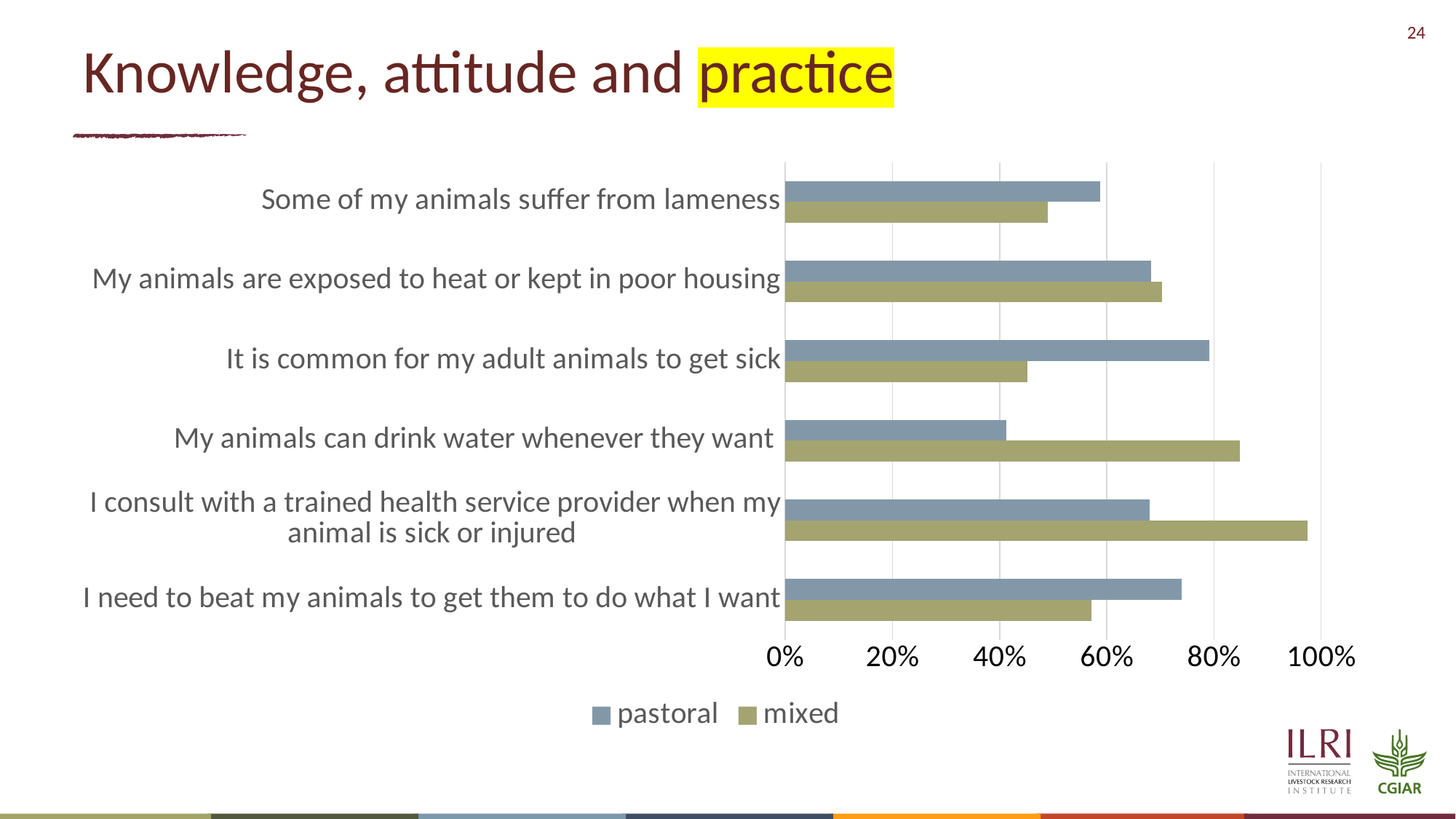
What are the two series named in the chart legend? pastoral and mixed Is the mixed value for 'It is common for my adult animals to get sick' greater or less than 60%? less Which statement has the lowest value for the pastoral series? My animals can drink water whenever they want Which statement has the highest value for the mixed series? I consult with a trained health service provider when my animal is sick or injured How many statements (categories) are plotted on the chart? 6 For 'My animals can drink water whenever they want', which series has the larger value, pastoral or mixed? mixed Is the pastoral value for 'I need to beat my animals to get them to do what I want' greater or less than 60%? greater Is the pastoral value for 'My animals can drink water whenever they want' greater or less than 60%? less How many series does the legend list? 2 What kind of chart is shown on the slide? bar chart For 'It is common for my adult animals to get sick', which series has the larger value, pastoral or mixed? pastoral